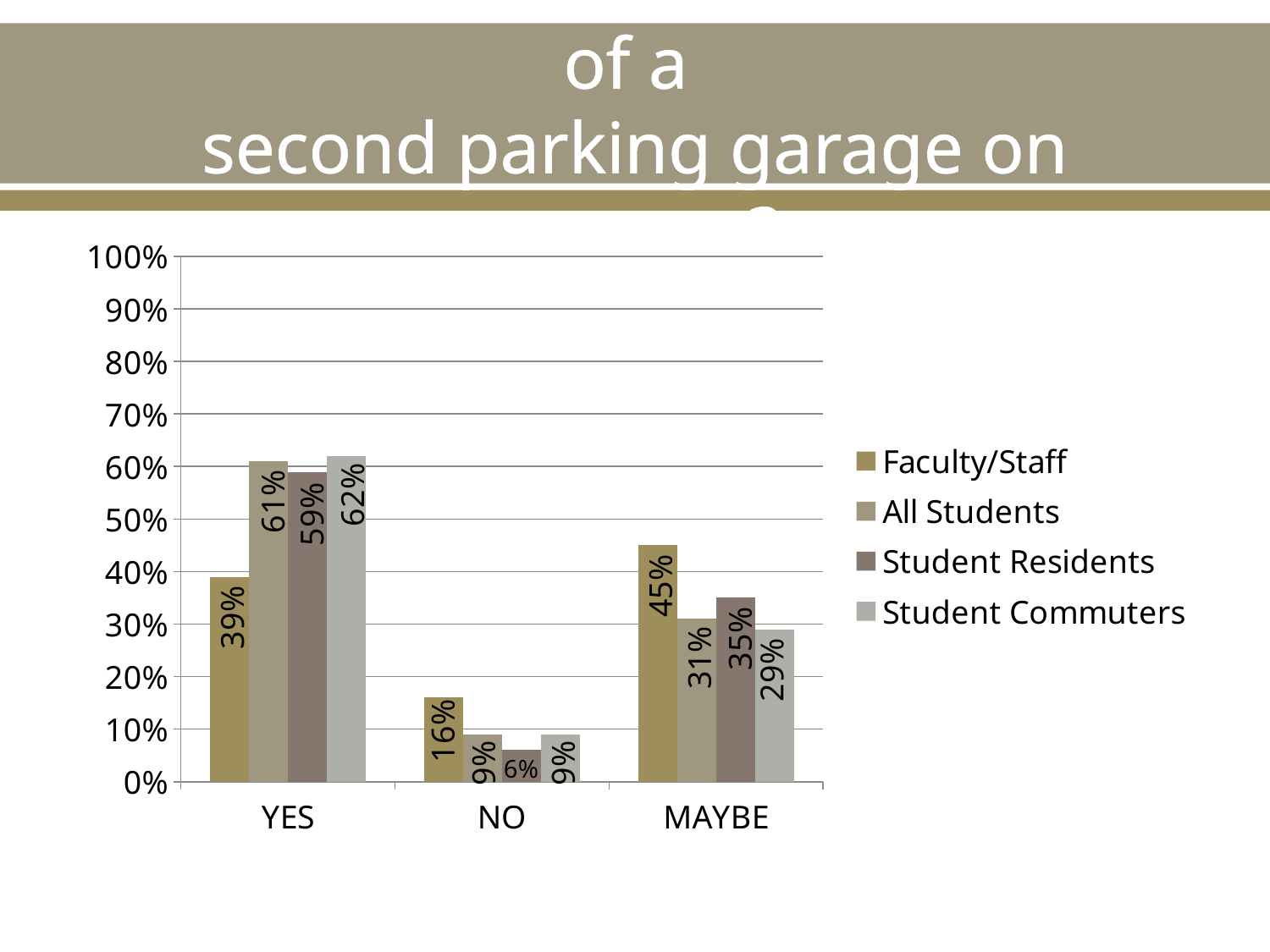
What is the value for Student Residents in the NO category? 6% Which series has the highest value in the MAYBE category? Faculty/Staff What is the value for Faculty/Staff in the YES category? 39% Which series has the lowest value in the YES category? Faculty/Staff What is the difference between the Faculty/Staff and All Students values in the NO category? 7% What kind of chart is shown on the slide? Bar chart How many categories are shown on the x axis? 3 What is the value for Student Commuters in the YES category? 62% Which is larger: the Student Residents value for MAYBE or the Student Commuters value for MAYBE? Student Residents What is the value for All Students in the MAYBE category? 31% How many series does the legend list? 4 What is the last entry in the legend? Student Commuters